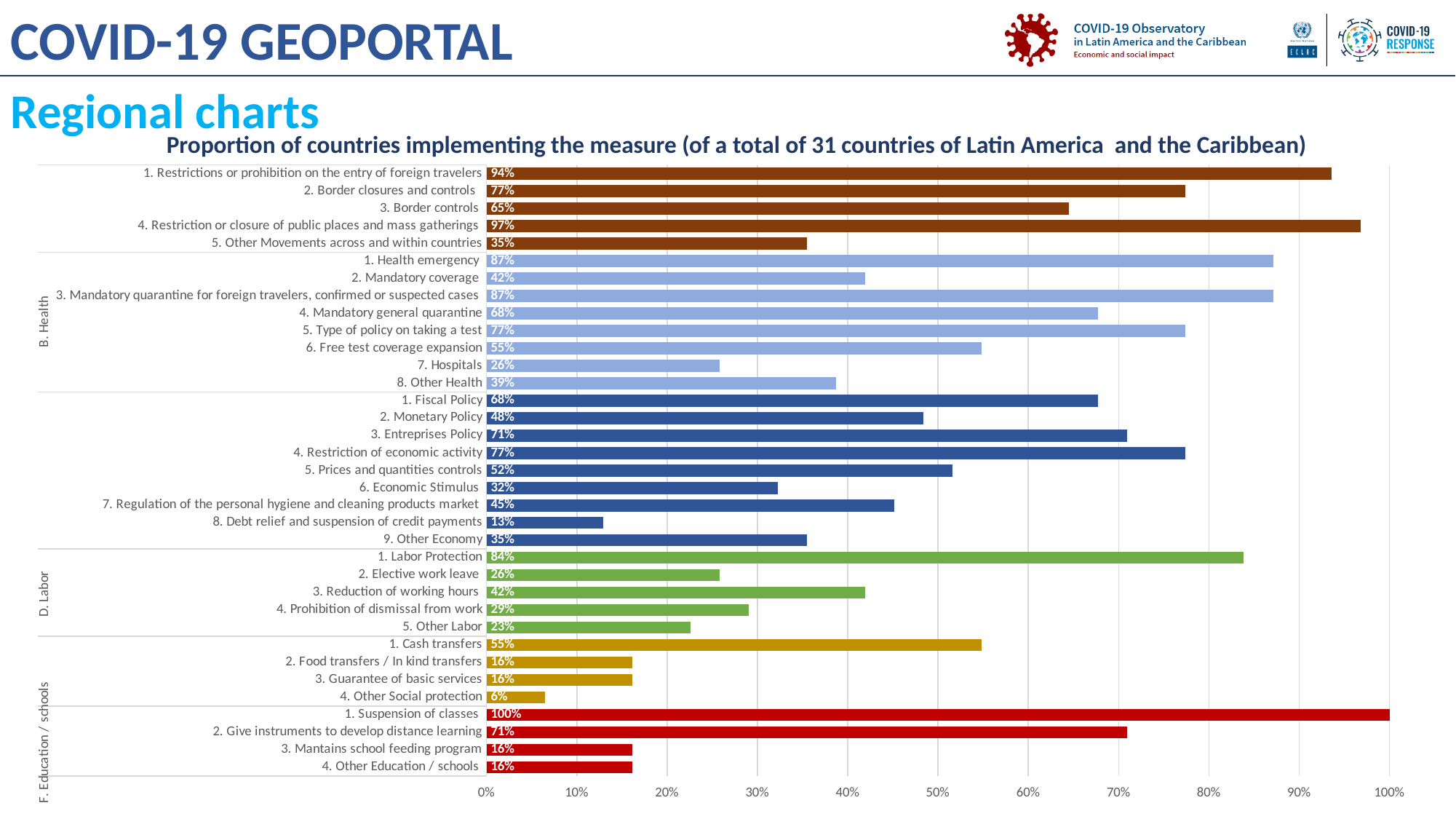
What is the value for "8. Debt relief and suspension of credit payments"? 13% Which measure has the lowest proportion of countries implementing it? 4. Other Social protection Is the value for "3. Entreprises Policy" greater or less than 60%? greater Which measure has the highest proportion of countries implementing it? 1. Suspension of classes Which is larger, the value for "2. Mandatory coverage" or the value for "6. Free test coverage expansion"? 6. Free test coverage expansion What is the value for "1. Restrictions or prohibition on the entry of foreign travelers"? 94% What kind of chart is shown on the slide? bar chart What is the difference between the values for "4. Restriction or closure of public places and mass gatherings" and "5. Other Movements across and within countries"? 62% What is the title of the chart? Proportion of countries implementing the measure (of a total of 31 countries of Latin America and the Caribbean) How many measures (bars) are plotted in the chart? 35 What is the value for "1. Cash transfers"? 55% What is the value for "1. Labor Protection"? 84%